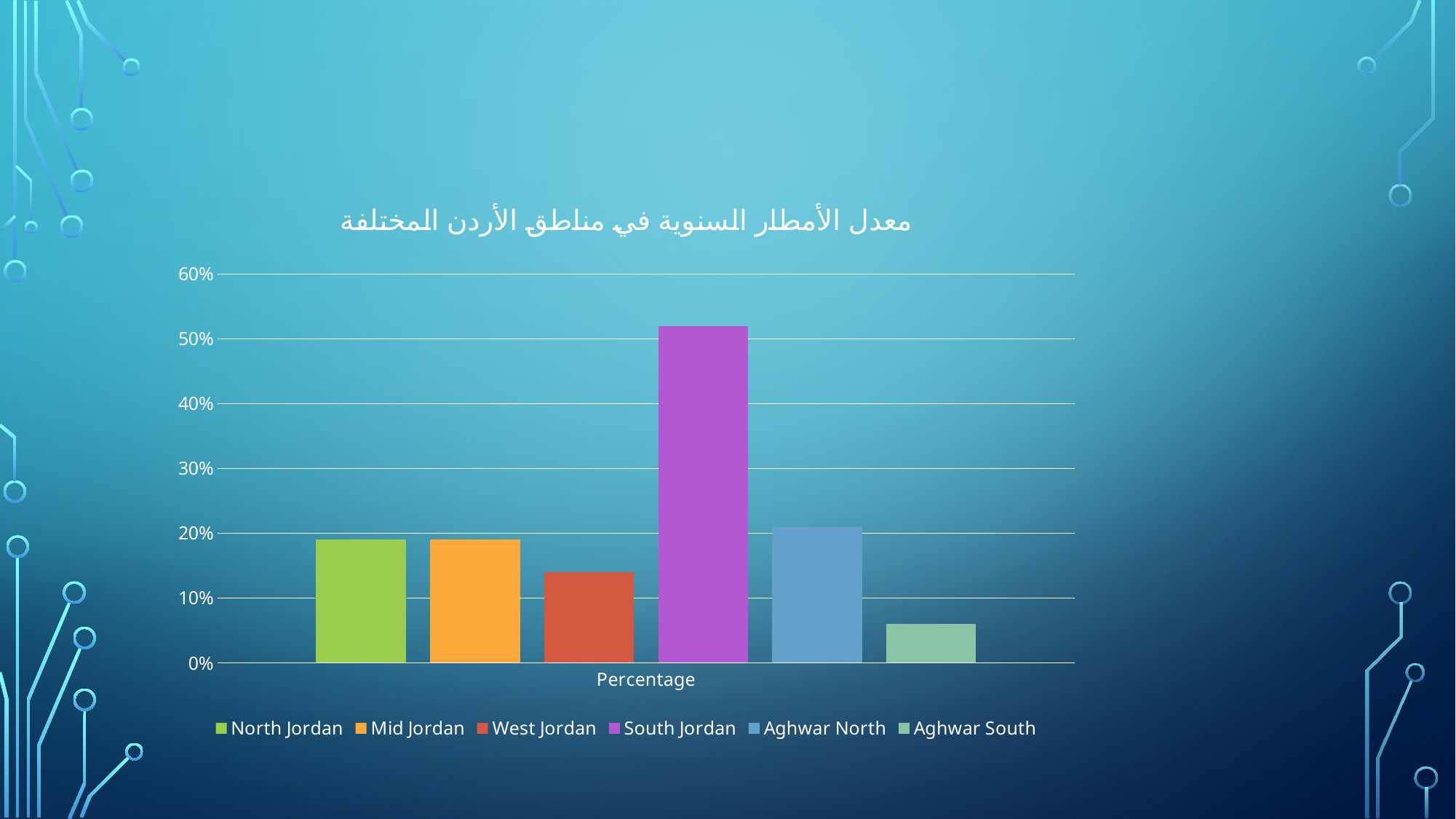
Which series has the highest bar? South Jordan Is the value for West Jordan greater or less than 10%? greater What kind of chart is shown on the slide? bar chart Is the value for Aghwar North greater or less than 30%? less Which series has the lowest bar? Aghwar South Is the value for South Jordan greater or less than 50%? greater What is the label shown on the x axis below the bars? Percentage Which is larger, the value for Aghwar North or the value for Aghwar South? Aghwar North How many series does the legend list? 6 What colour is the bar for South Jordan? purple Which is larger, the value for South Jordan or the value for West Jordan? South Jordan